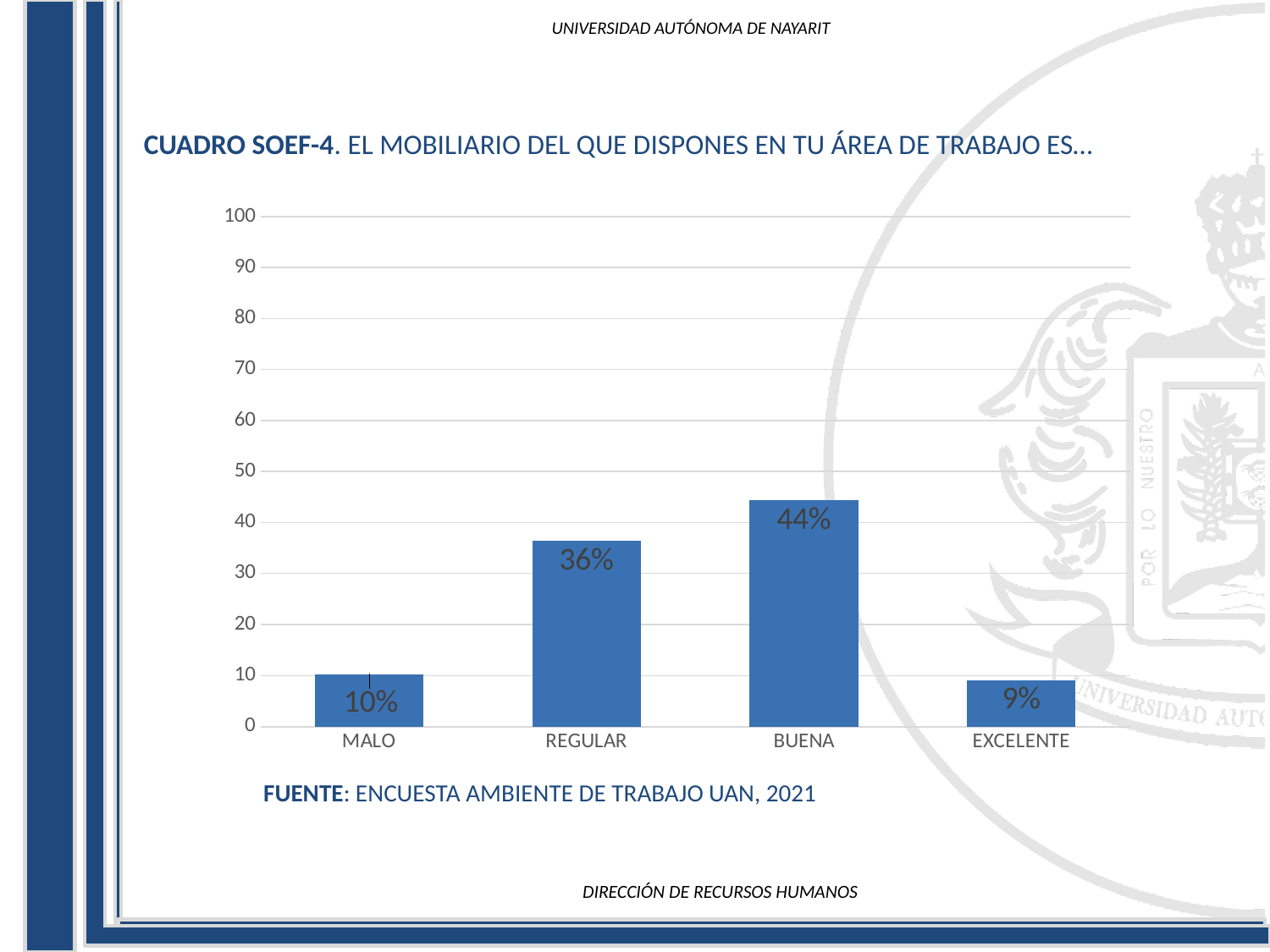
What is the difference between the values for BUENA and REGULAR? 8% Which category has the highest value? BUENA What is the difference between the values for MALO and EXCELENTE? 1% Which is larger, the value for REGULAR or the value for MALO? REGULAR What is the value for MALO? 10% Is the value for REGULAR greater or less than 30? greater Which category has the lowest value? EXCELENTE What is the value for EXCELENTE? 9% What is the value for BUENA? 44% How many categories are shown on the x axis? 4 What kind of chart is shown on the slide? bar chart What is the source cited below the chart? ENCUESTA AMBIENTE DE TRABAJO UAN, 2021